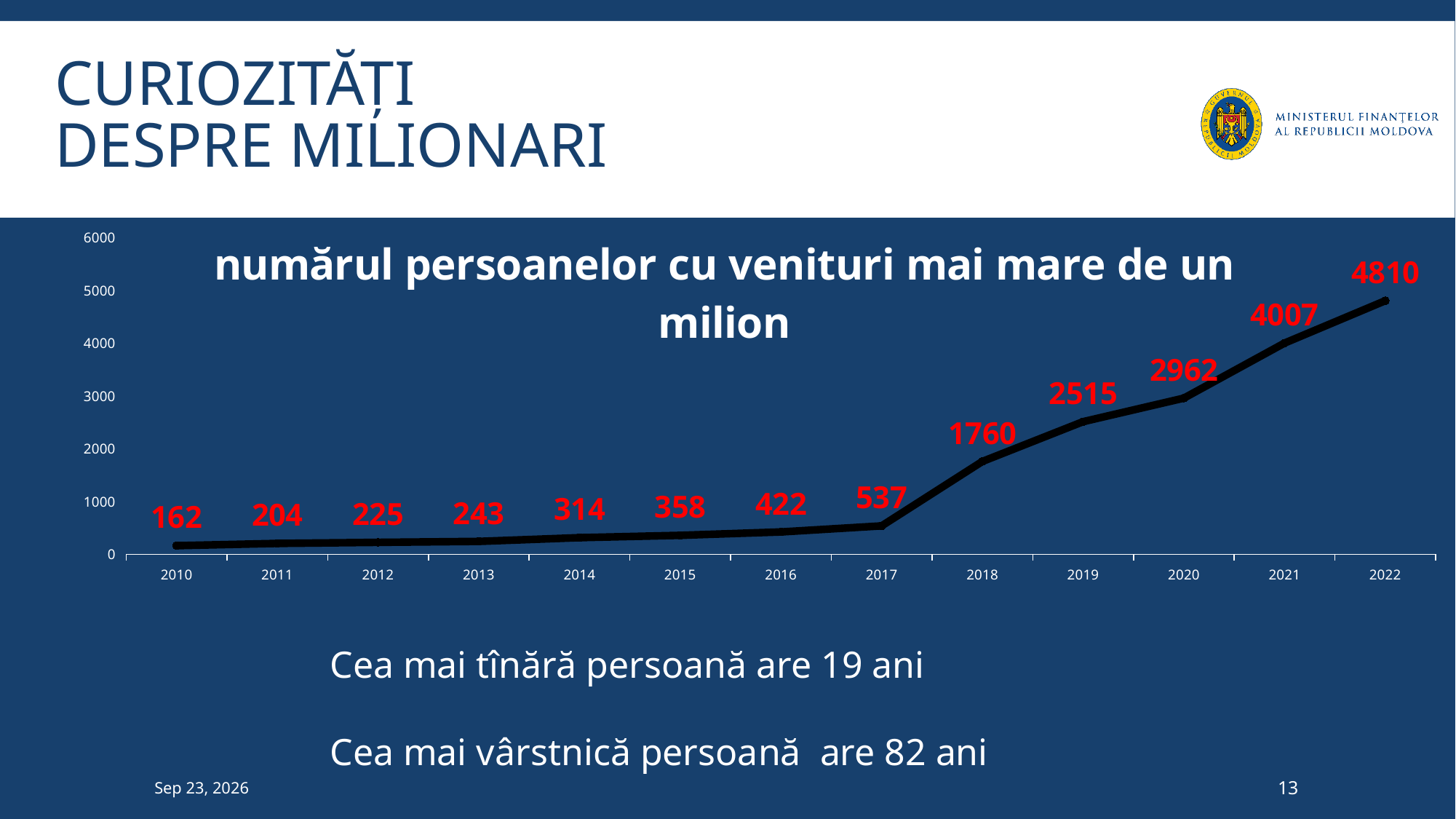
Do the values rise or fall from 2010 to 2022? rise What kind of chart is this? line chart What is the difference between the values for 2018 and 2017? 1223 What is the value for 2021? 4007 What is the value for 2017? 537 What is the difference between the values for 2022 and 2021? 803 Which is larger, the value for 2019 or the value for 2020? 2020 Which year has the highest value? 2022 Is the value for 2020 greater or less than 3000? less Which year has the lowest value? 2010 What is the value for 2010? 162 How many years are shown on the x axis? 13